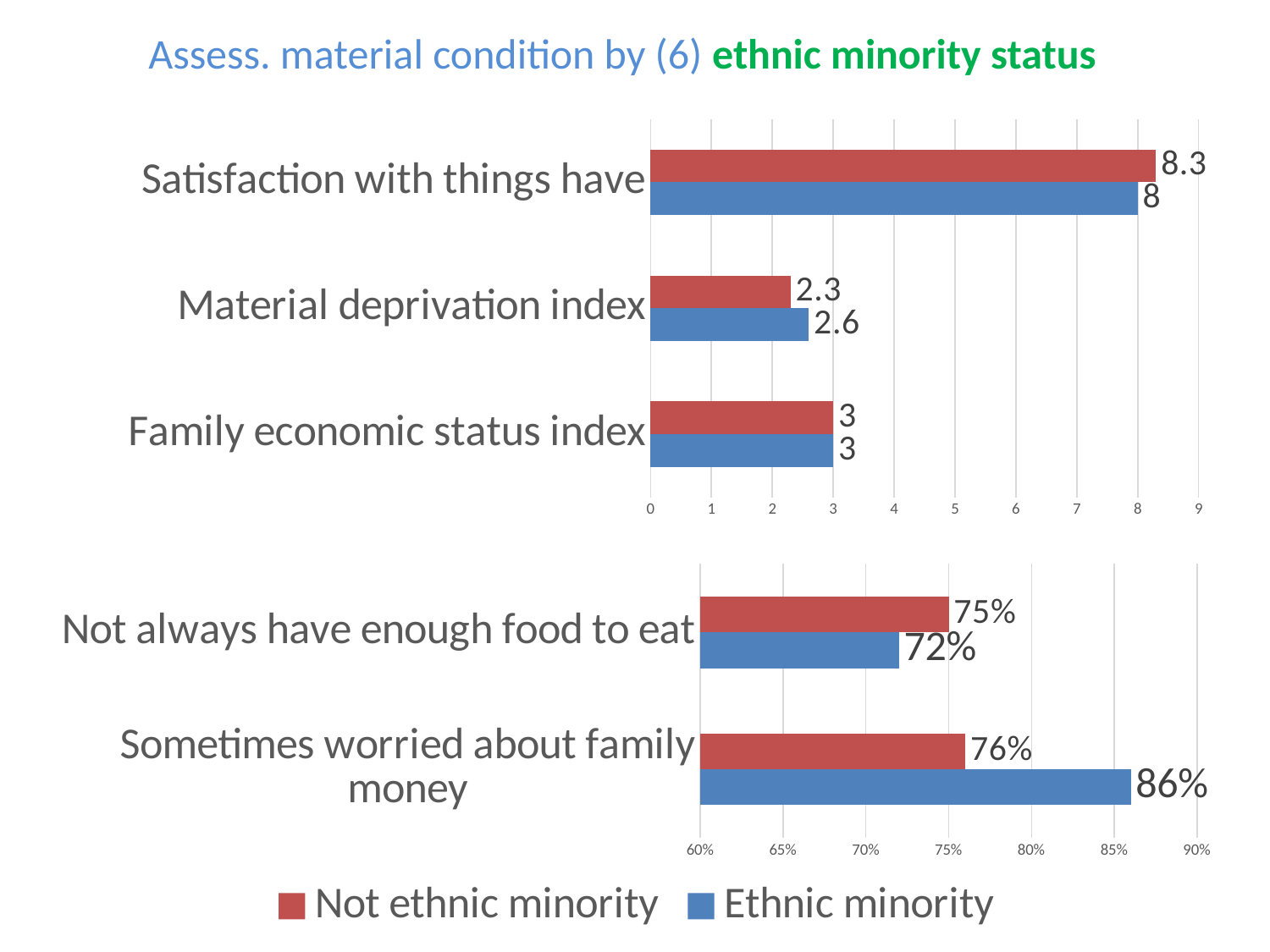
In the top chart, what is the value for Not ethnic minority on Material deprivation index? 2.3 In the bottom chart, what is the value for Ethnic minority on Sometimes worried about family money? 86% What type of chart is the bottom chart? Bar chart How many categories does the top chart show? 3 In the top chart, what is the difference between the Not ethnic minority and Ethnic minority values for Satisfaction with things have? 0.3 In the bottom chart, what is the value for Not ethnic minority on Not always have enough food to eat? 75% In the top chart, which category has the highest value for Not ethnic minority? Satisfaction with things have In the top chart, what is the value for Ethnic minority on Satisfaction with things have? 8 How many series does the legend list? 2 In the top chart, which is larger for Material deprivation index: Not ethnic minority or Ethnic minority? Ethnic minority In the bottom chart, which category has the lowest value for Ethnic minority? Not always have enough food to eat In the bottom chart, what is the difference between the Ethnic minority and Not ethnic minority values for Sometimes worried about family money? 10%